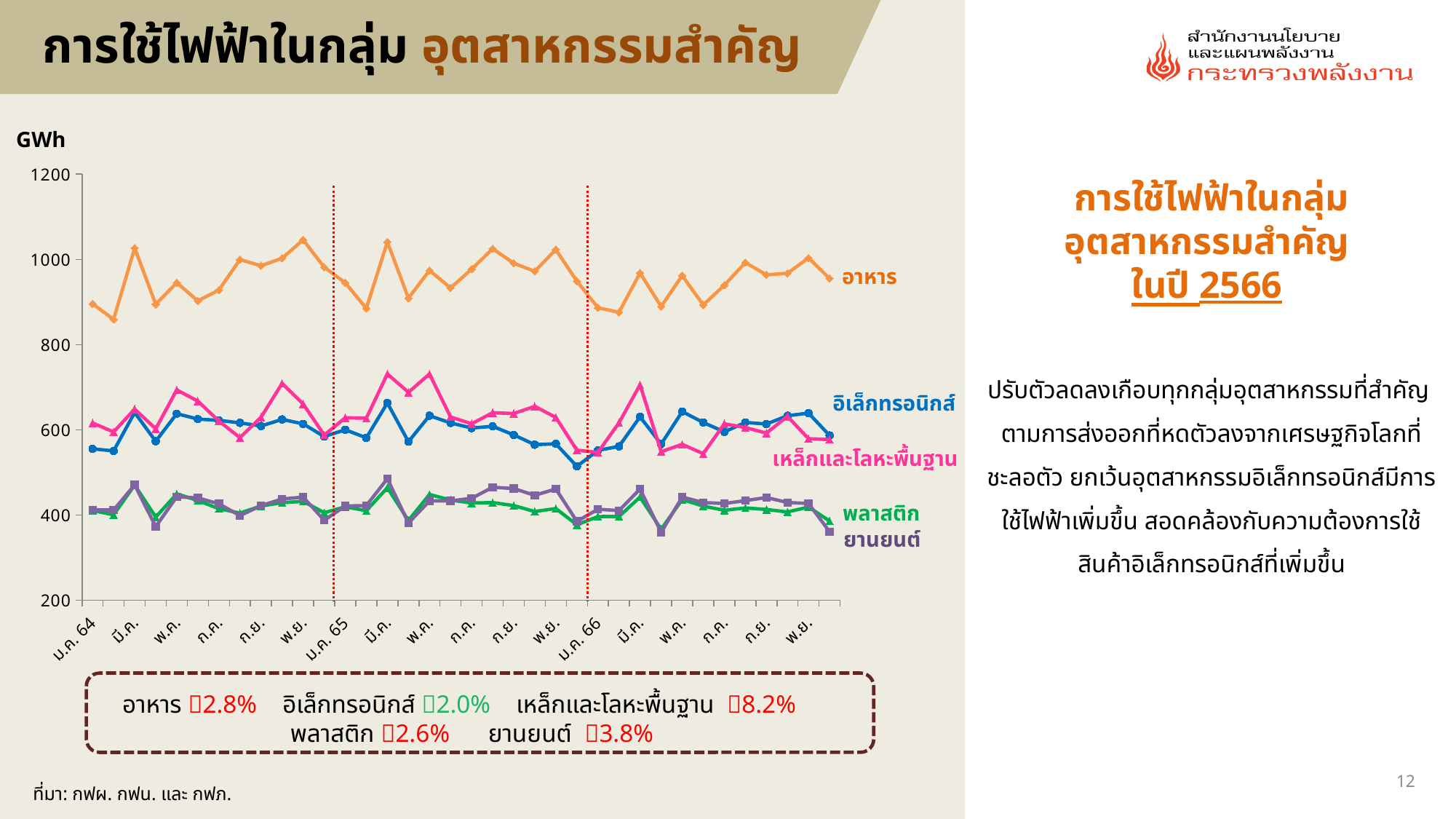
What is the first x-axis label on the chart? ม.ค. 64 Which series has the highest values across the whole chart? อาหาร Is the value for อาหาร at พ.ย. 64 greater or less than 1000? greater What kind of chart is shown on the slide? line chart Is the value for เหล็กและโลหะพื้นฐาน at มี.ค. 65 greater or less than 700? greater Is the value for พลาสติก at ม.ค. 64 greater or less than 600? less At ม.ค. 66, which is larger: อาหาร or อิเล็กทรอนิกส์? อาหาร How many data series are plotted in the chart? 5 What unit is shown on the y axis of the chart? GWh At ม.ค. 64, which is larger: อิเล็กทรอนิกส์ or เหล็กและโลหะพื้นฐาน? เหล็กและโลหะพื้นฐาน